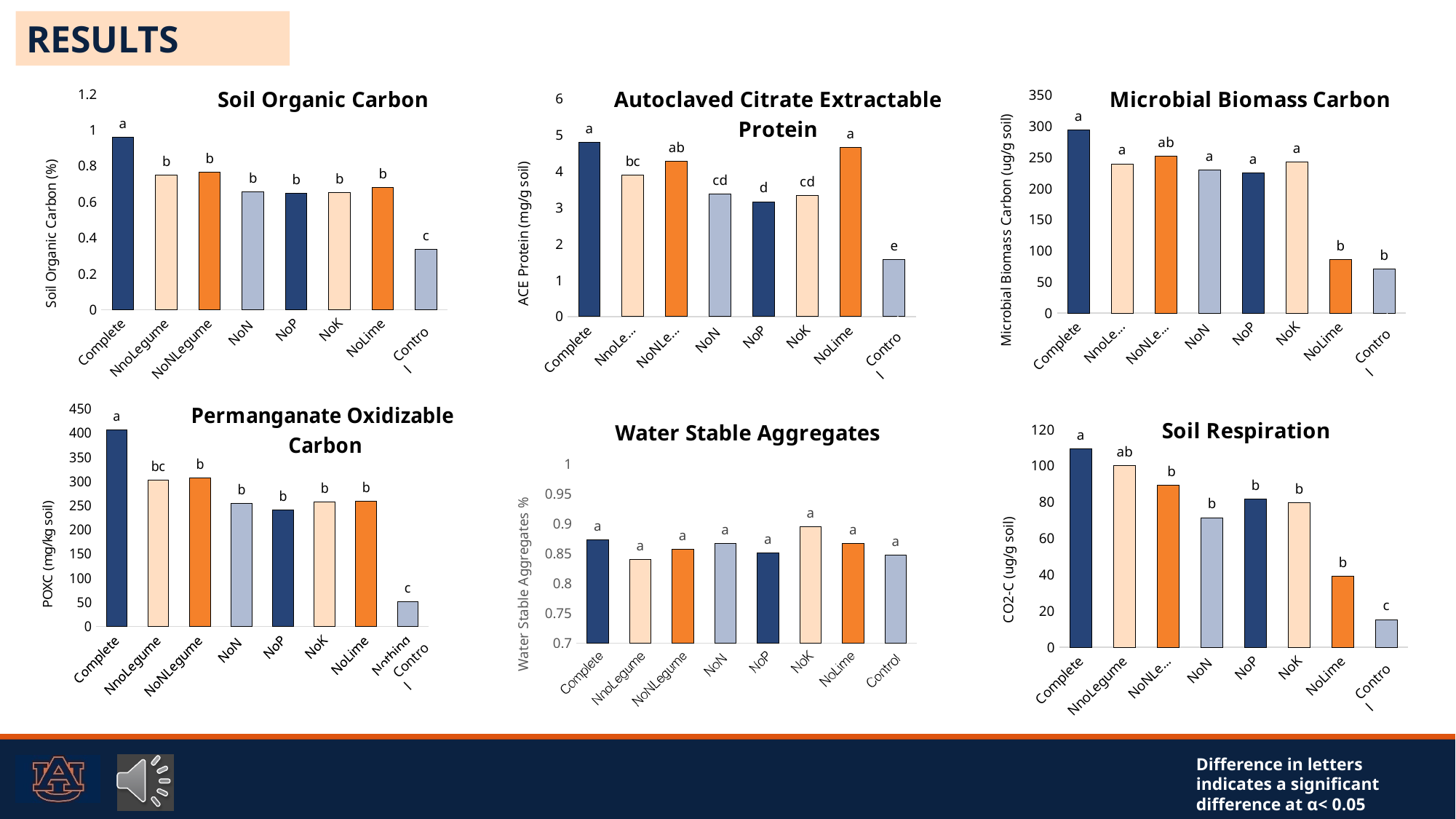
In the Soil Organic Carbon chart, which category has the highest bar? Complete In the Permanganate Oxidizable Carbon chart, is the value for Complete greater or less than 350? greater What kind of chart is the Soil Respiration chart? bar chart In the Autoclaved Citrate Extractable Protein chart, is the value for NoP greater or less than 4? less In the Soil Organic Carbon chart, is the value for Complete greater or less than 0.8? greater In the Microbial Biomass Carbon chart, which is larger, the value for NoN or the value for NoLime? NoN In the Soil Organic Carbon chart, which category has the lowest bar? Control How many bars are plotted in the Permanganate Oxidizable Carbon chart? 8 In the Autoclaved Citrate Extractable Protein chart, which category has the lowest bar? Control In the Water Stable Aggregates chart, which category has the highest bar? NoK